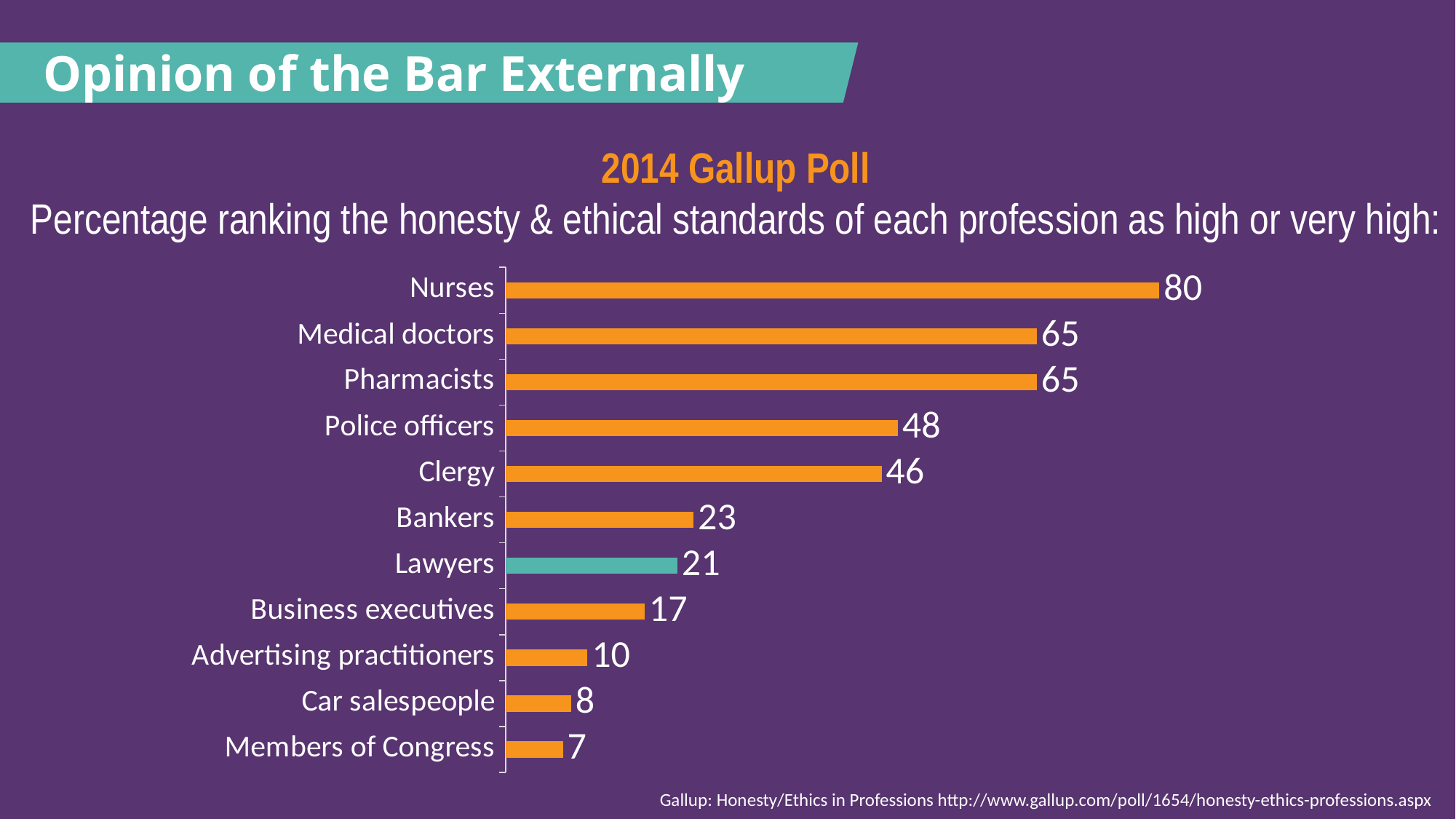
What is the value shown for Nurses? 80 Which profession's bar is coloured differently (teal) from the others? Lawyers What kind of chart is shown on the slide? Bar chart Which profession has the lowest value in the chart? Members of Congress Which profession has the highest value in the chart? Nurses Which has a higher value, Clergy or Bankers? Clergy What is the value shown for Police officers? 48 What is the difference between the values for Bankers and Business executives? 6 What is the difference between the values for Nurses and Lawyers? 59 What percentage of respondents ranked the honesty and ethical standards of Lawyers as high or very high? 21 How many professions are shown in the chart? 11 Which two professions share the same value of 65? Medical doctors and Pharmacists